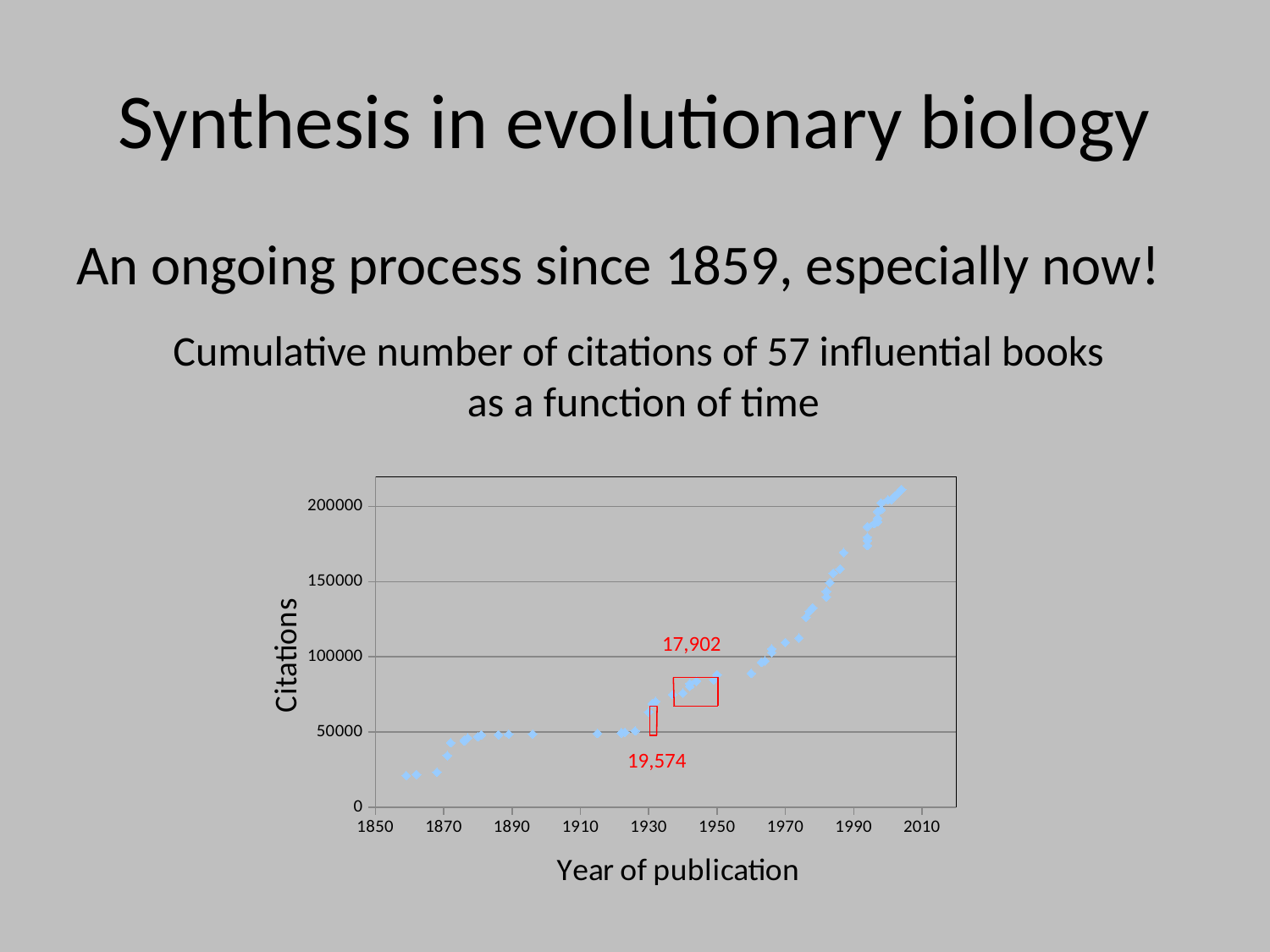
What number is printed in red above the upper red box on the chart? 17,902 What kind of chart is shown on the slide? scatter chart Is the citation value for the points around 1950 greater or less than 100000? less What is the label of the x axis? Year of publication What is the label of the y axis? Citations Is the citation value for the latest point (around 2005) greater or less than 200000? greater What number is printed in red below the lower red box on the chart? 19,574 Do the citation values rise or fall as the year of publication increases? rise How many tick labels are shown on the x axis? 9 Is the citation value for the earliest point (around 1860) greater or less than 50000? less Which has more citations: the point around 1860 or the point around 2005? the point around 2005